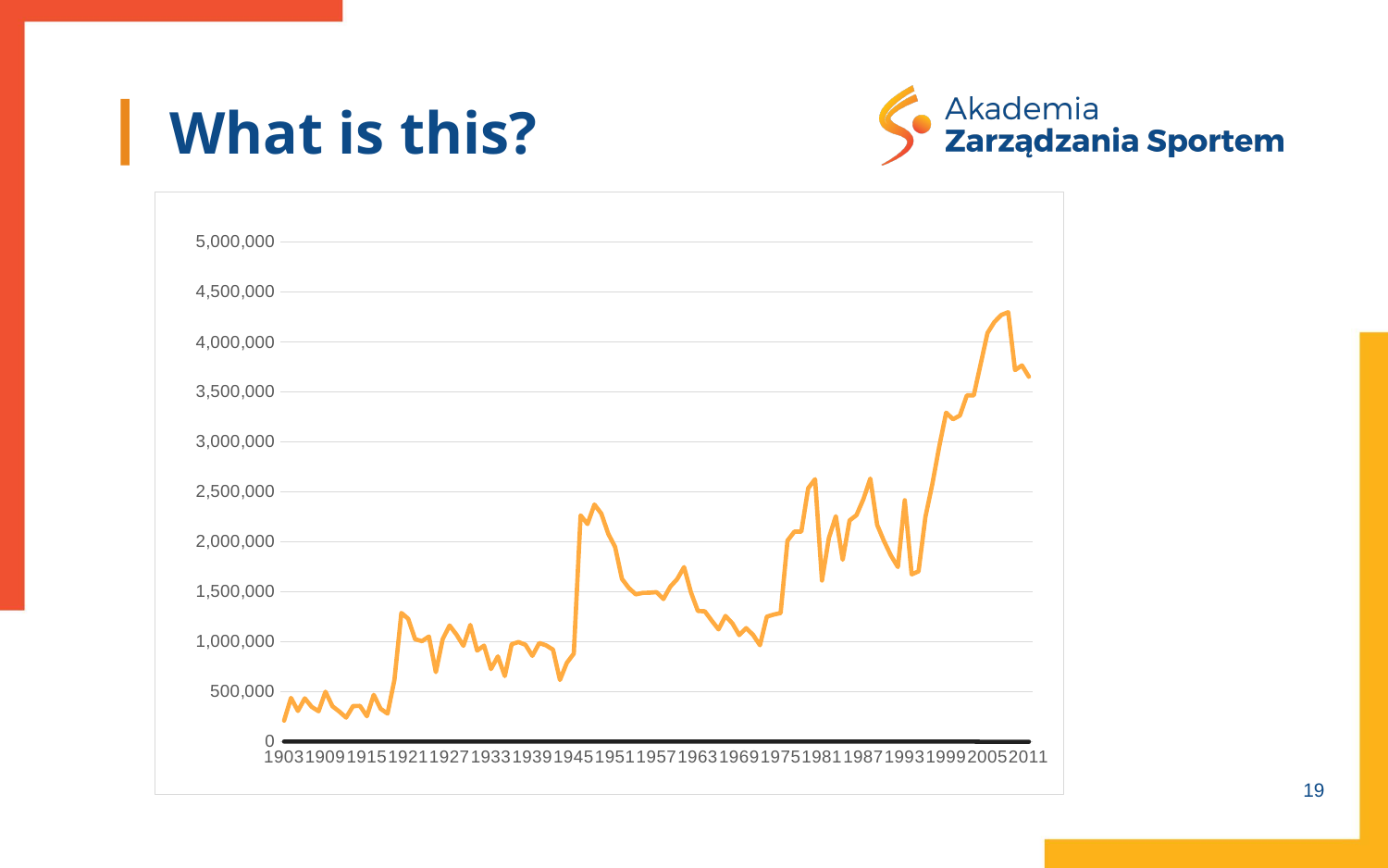
Which year has the larger value, 1903 or 2011? 2011 Is the value for 2005 greater or less than 3,500,000? greater Which year has the larger value, 1921 or 1927? 1921 Is the value for 1903 greater or less than 500,000? less What kind of chart is shown on the slide? line chart How many year labels are shown on the x axis? 19 Does the line ever exceed 4,500,000? no Overall, do the values rise or fall from 1903 to 2011? rise What colour is the plotted line? orange What is the highest value labelled on the y axis? 5,000,000